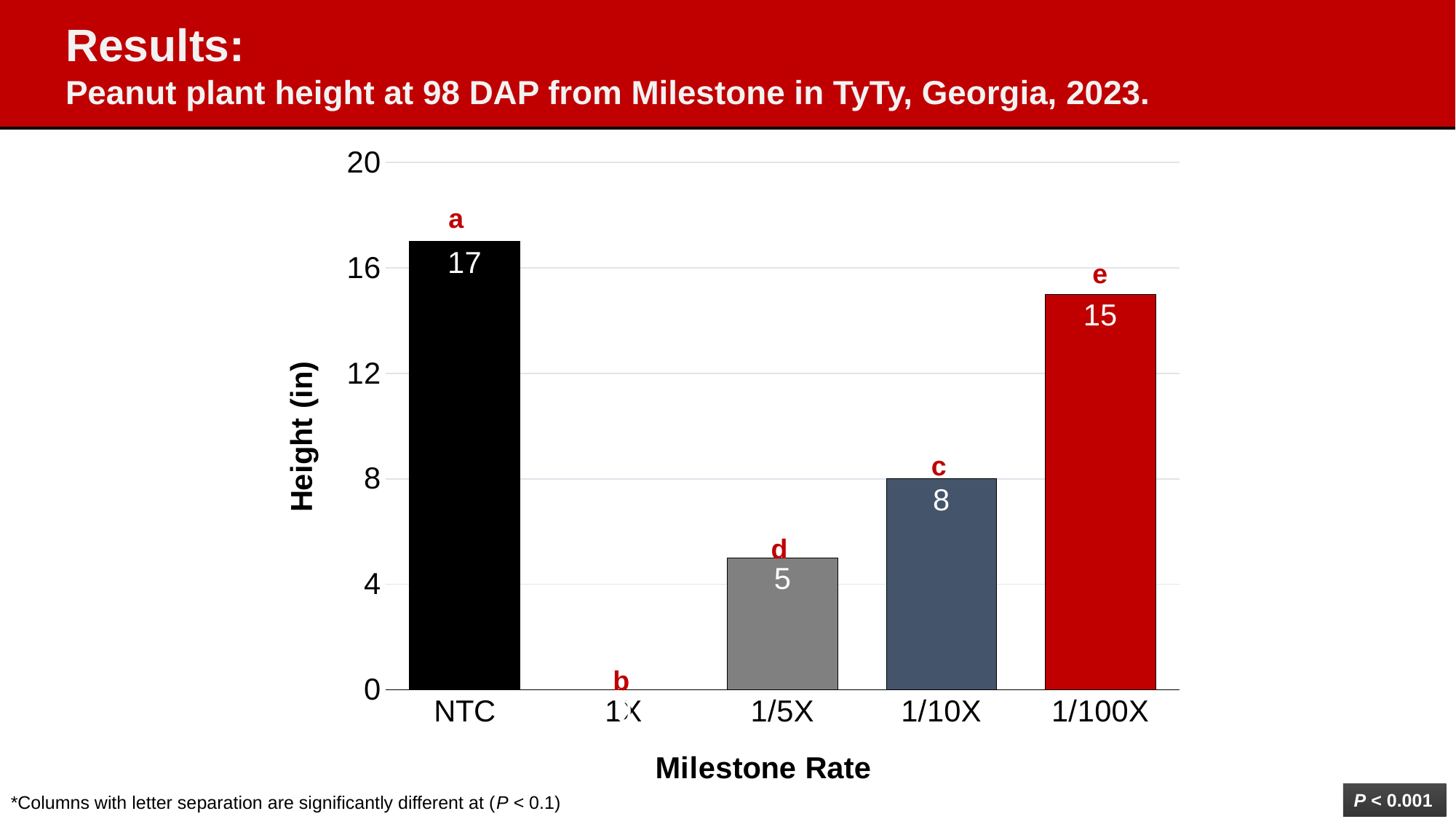
What is the difference in height between NTC and 1/100X? 2 Which Milestone rate has the greatest plant height? NTC What is the height for NTC? 17 What is the label of the y axis? Height (in) Which Milestone rate has the lowest plant height? 1X Which has a greater height, 1/10X or 1/5X? 1/10X How many Milestone rate categories are shown on the x axis? 5 What kind of chart is shown on the slide? Bar chart What is the height for 1/100X? 15 What is the height for 1/5X? 5 What is the height for 1/10X? 8 What is the difference in height between 1/10X and 1/5X? 3